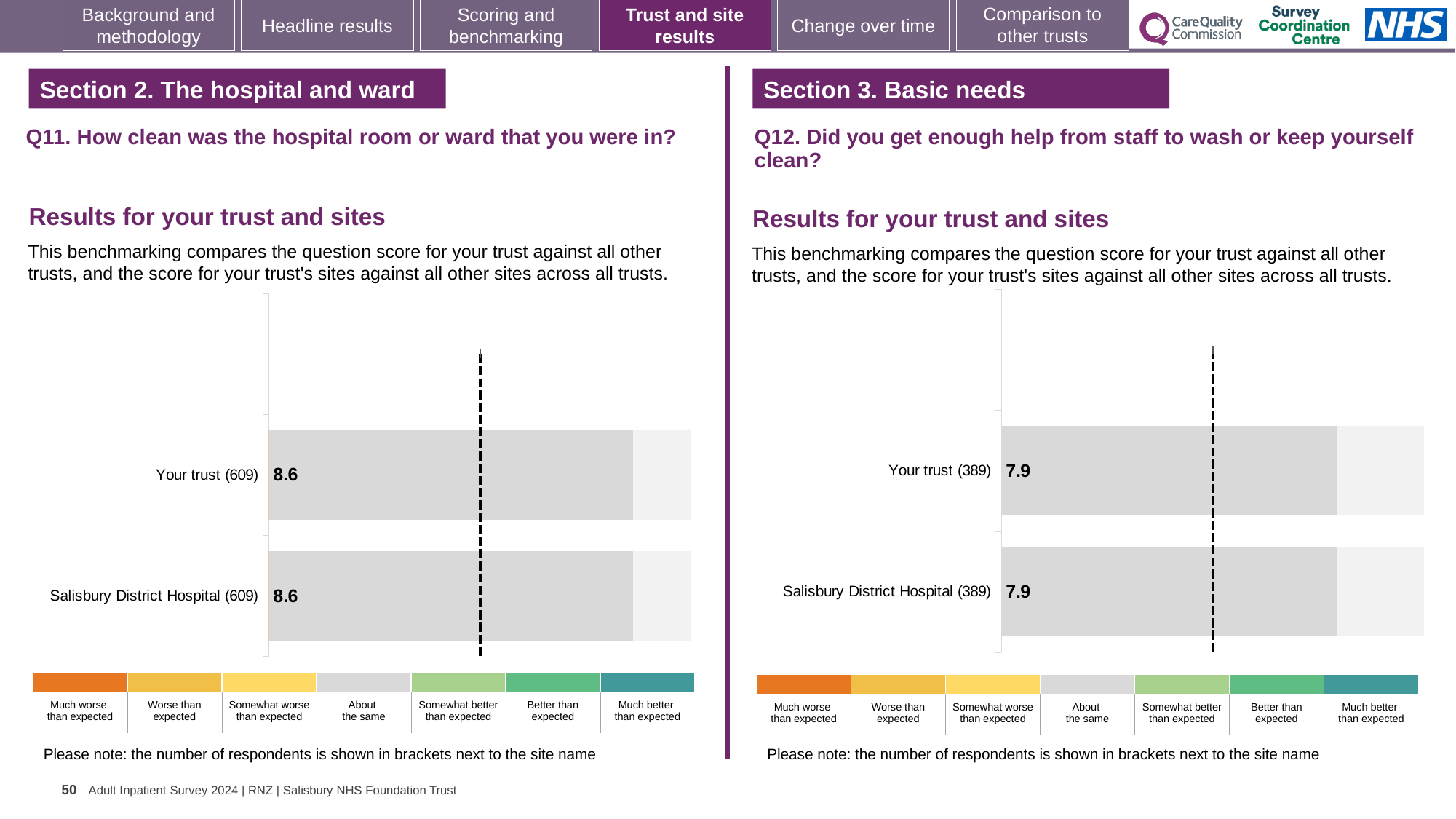
What kind of chart is used for the Q11 results on the left? Bar chart In the Q11 chart on the left, what is the difference between the score for Your trust and the score for Salisbury District Hospital? 0 In the Q12 chart on the right, what is the score for Salisbury District Hospital? 7.9 How many bars are plotted in the Q12 chart on the right? 2 How many bars are plotted in the Q11 chart on the left? 2 In the Q12 chart on the right, how many respondents are shown in brackets next to Salisbury District Hospital? 389 In the Q11 chart on the left, what is the score for Your trust? 8.6 In the Q12 chart on the right, what is the difference between the score for Your trust and the score for Salisbury District Hospital? 0 In the Q11 chart on the left, what is the score for Salisbury District Hospital? 8.6 Is the score for Your trust in the Q11 chart on the left larger or smaller than the score for Your trust in the Q12 chart on the right? Larger In the Q12 chart on the right, what is the score for Your trust? 7.9 In the Q11 chart on the left, how many respondents are shown in brackets next to Your trust? 609